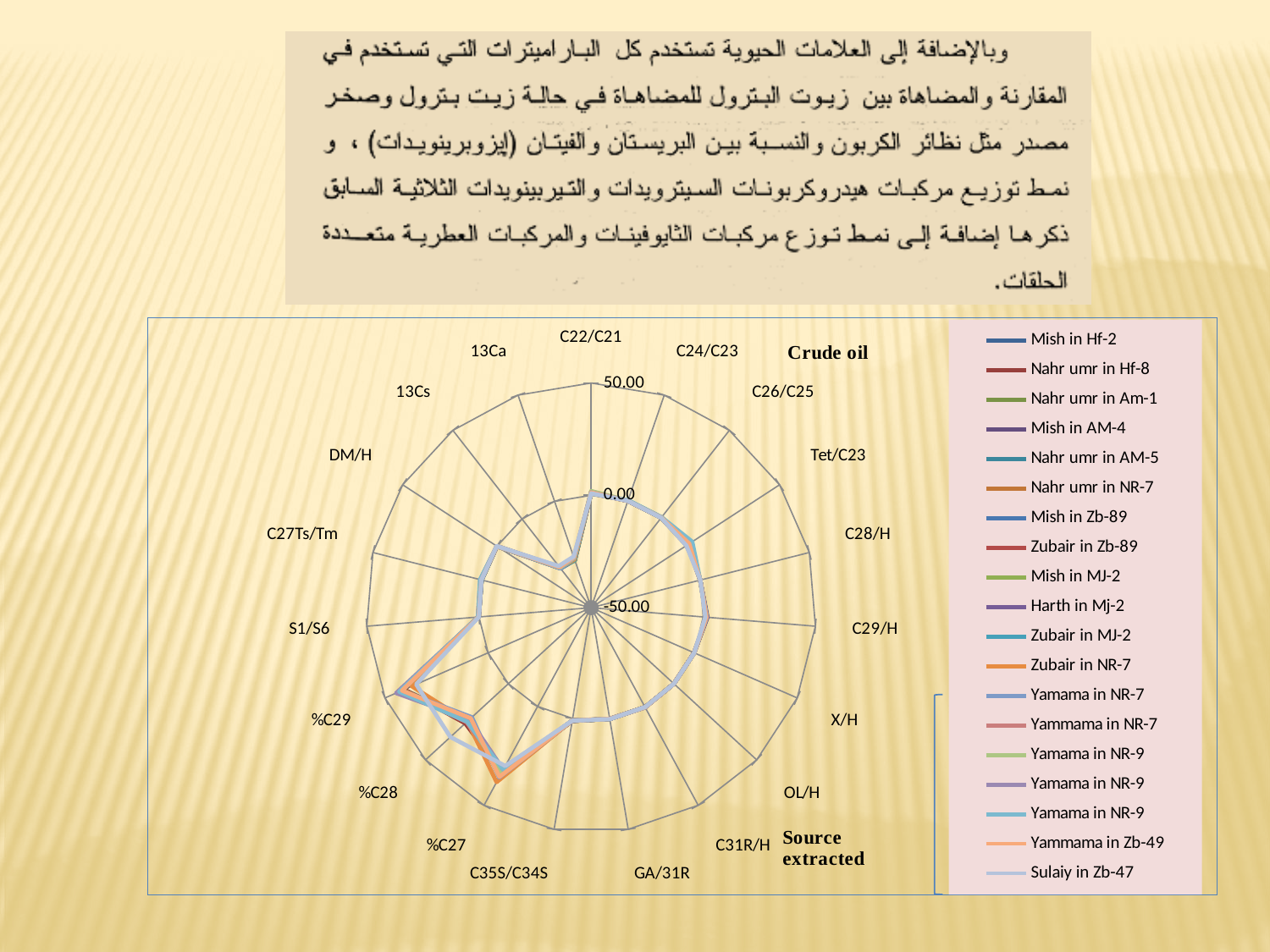
What is the lowest value labelled on the radar chart's axis? -50.00 What kind of chart is shown on the slide? Radar chart Are the values plotted for C29/H greater or less than 50.00? less Are the values plotted for 13Ca greater or less than 0.00? less How many series does the legend of the radar chart list? 19 What is the highest value labelled on the radar chart's axis? 50.00 Are the values plotted for %C28 greater or less than 0.00? greater How many categories (axes) does the radar chart have? 19